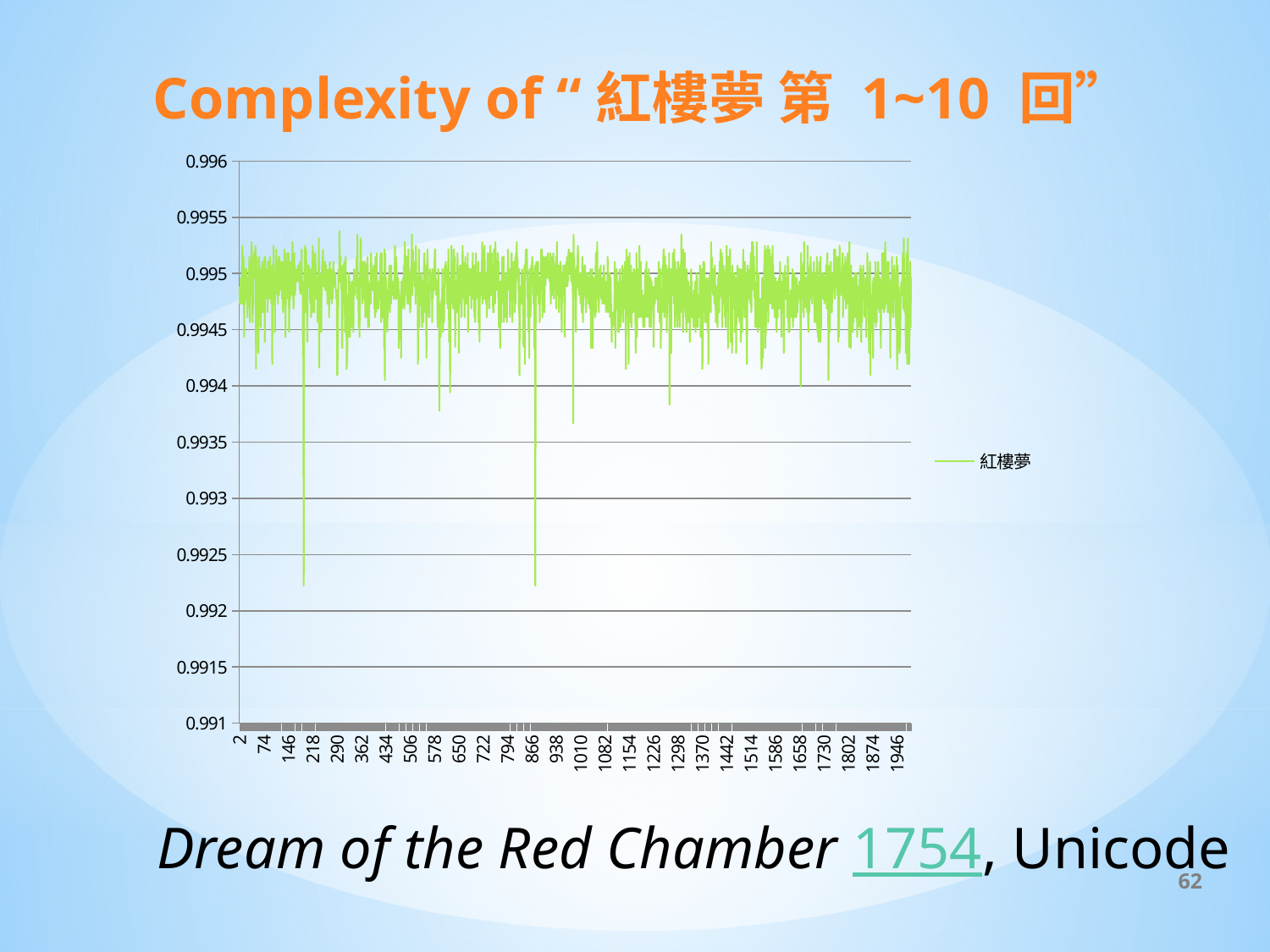
What is the last tick label on the chart's x axis? 1946 How many series does the chart legend list? 1 What kind of chart is shown on the slide? line chart What is the lowest value shown on the chart's y axis? 0.991 What is the highest value shown on the chart's y axis? 0.996 What colour is the plotted line for 紅樓夢? green Is the highest value plotted on the chart greater or less than 0.9955? less What is the first tick label on the chart's x axis? 2 Is the lowest value plotted on the chart greater or less than 0.9925? less What is the name of the series shown in the chart legend? 紅樓夢 Does the plotted line show a strong overall rising or falling trend along the x axis, or does it stay roughly flat? roughly flat